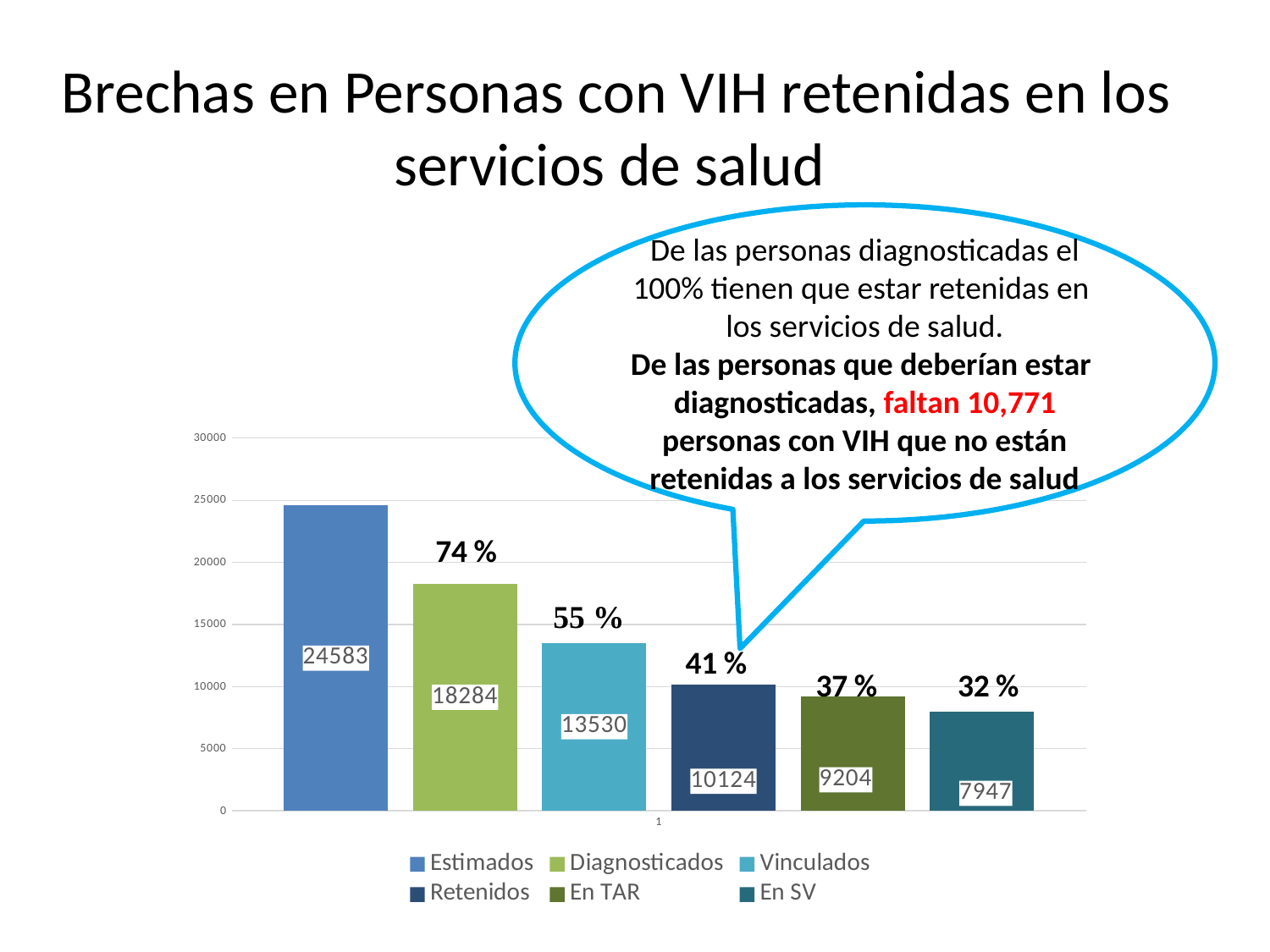
Which series has the lowest value? En SV Which is larger, the value for Vinculados or the value for Retenidos? Vinculados What kind of chart is shown on the slide? bar chart What is the value for En SV? 7947 What is the difference between the Retenidos value and the En TAR value? 920 What is the value for Estimados? 24583 Is the value for Diagnosticados greater or less than 20000? less Which series has the highest value? Estimados What is the value for Retenidos? 10124 What is the difference between the Estimados value and the Diagnosticados value? 6299 What percentage is printed above the Retenidos bar? 41 % How many series does the legend list? 6